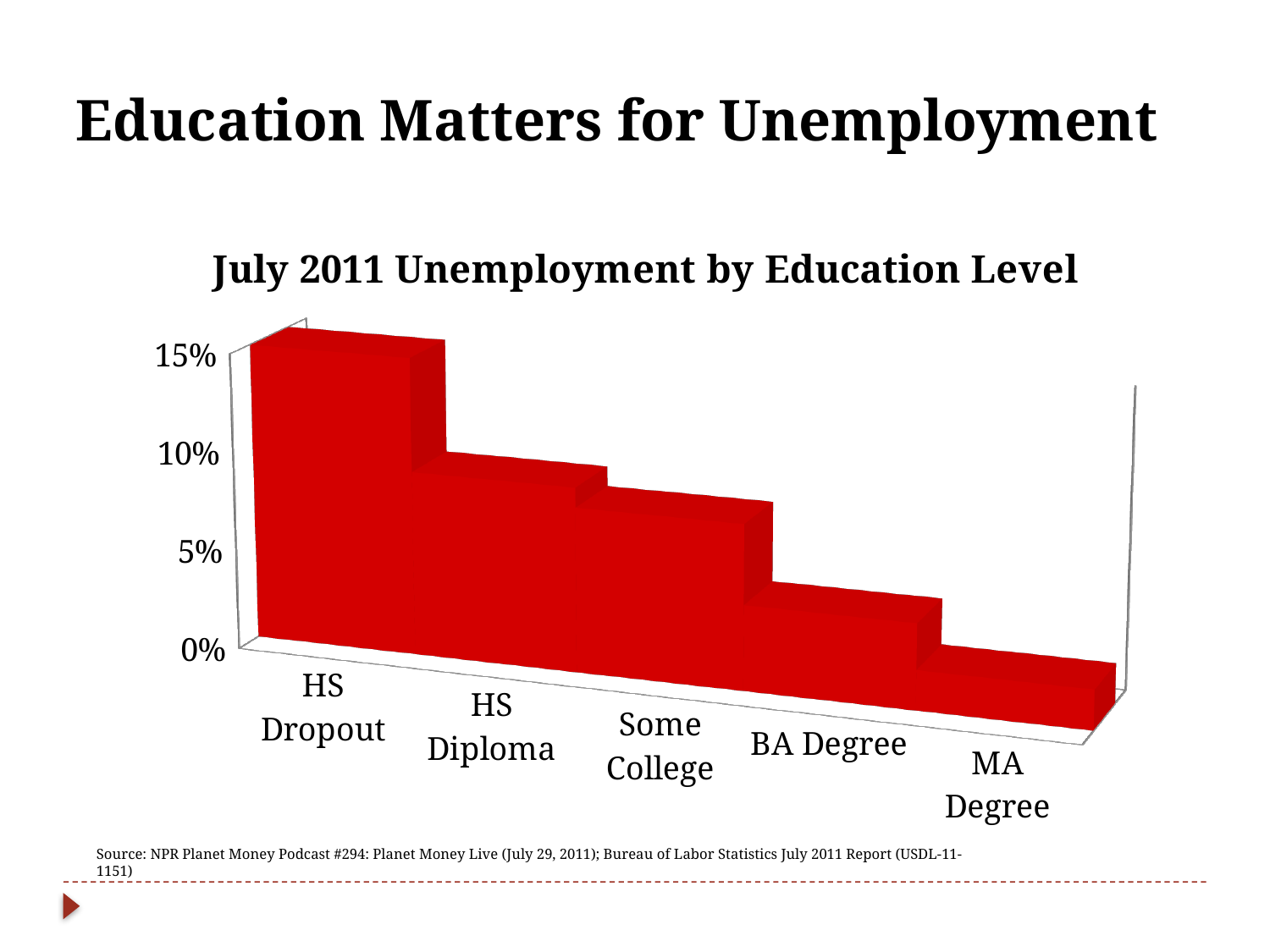
Is the unemployment rate for Some College greater or less than 10%? less Which education level has the lowest unemployment rate? MA Degree How many education levels are shown on the x axis? 5 What is the title of the chart? July 2011 Unemployment by Education Level Is the unemployment rate for HS Dropout greater or less than 10%? greater Which has a higher unemployment rate, HS Dropout or BA Degree? HS Dropout Is the unemployment rate for Some College greater or less than 5%? greater What kind of chart is shown on the slide? bar chart Which education level has the highest unemployment rate? HS Dropout Do the unemployment rates rise or fall moving from HS Dropout to MA Degree along the x axis? fall What colour are the bars in the chart? red